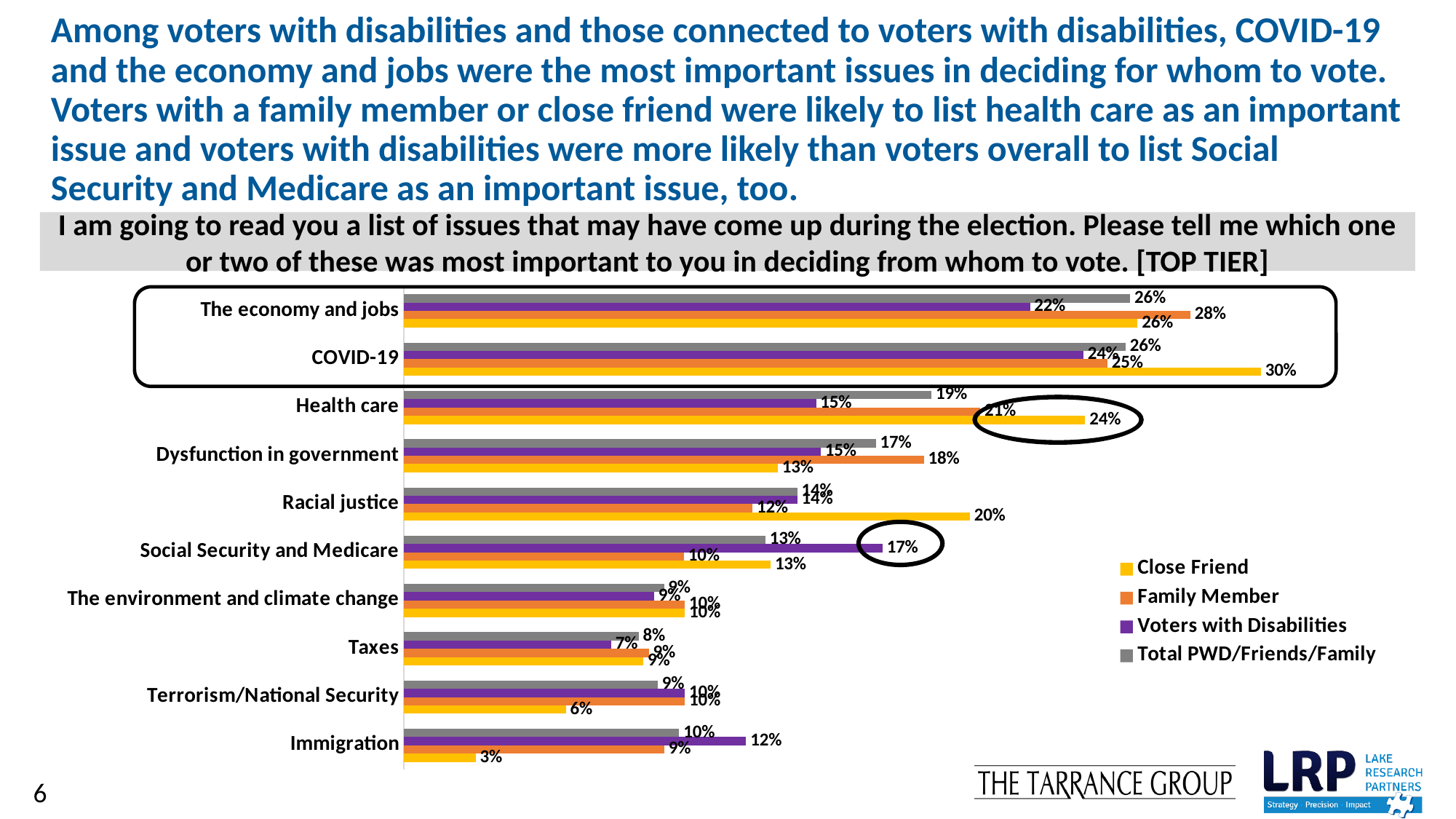
How many series does the legend list? 4 What is the Total PWD/Friends/Family value for Health care? 19% What is the Voters with Disabilities value for Social Security and Medicare? 17% What is the Close Friend value for Immigration? 3% For Dysfunction in government, which is larger: the Family Member value or the Close Friend value? Family Member What percentage of Close Friend respondents listed COVID-19 as a most important issue? 30% What kind of chart is shown on the slide? Bar chart Which issue has the highest Close Friend value? COVID-19 How many issues are listed on the chart? 10 Which issue has the lowest Close Friend value? Immigration What is the Family Member value for The economy and jobs? 28% What is the difference between the Close Friend and Voters with Disabilities values for Racial justice? 6%